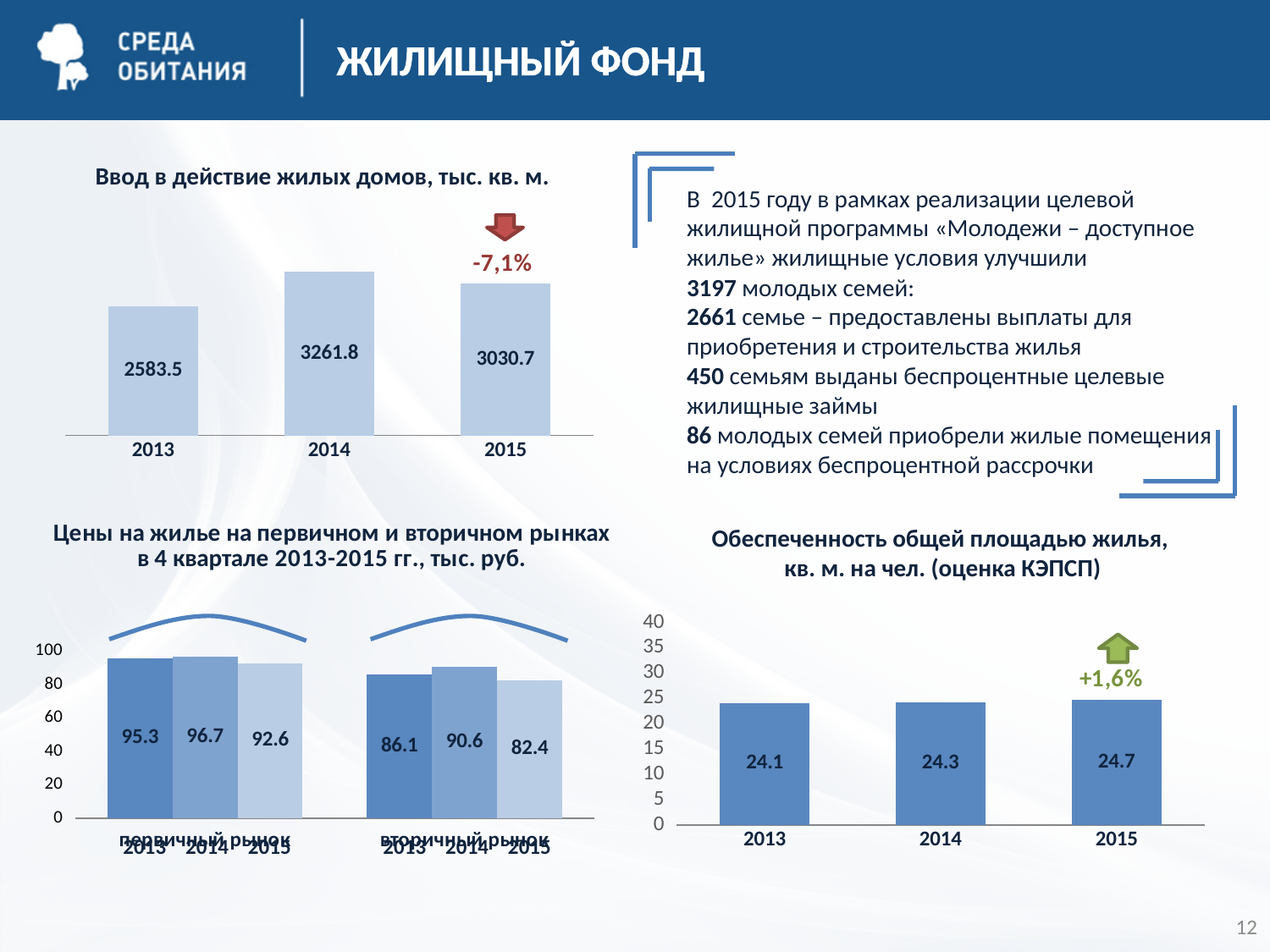
In the chart 'Цены на жилье на первичном и вторичном рынках', what is the difference between the 2014 and 2015 values on the вторичный рынок? 8.2 In the chart 'Обеспеченность общей площадью жилья, кв. м. на чел.', do the values rise or fall from 2013 to 2015? rise In the chart 'Цены на жилье на первичном и вторичном рынках', what is the value for 2014 on the первичный рынок? 96.7 In the chart 'Цены на жилье на первичном и вторичном рынках', what is the value for 2015 on the вторичный рынок? 82.4 In the chart 'Цены на жилье на первичном и вторичном рынках', which is larger: the 2013 value for первичный рынок or the 2013 value for вторичный рынок? первичный рынок In the chart 'Ввод в действие жилых домов, тыс. кв. м.', what percentage change is annotated above the 2015 bar? -7,1% What kind of chart is 'Обеспеченность общей площадью жилья, кв. м. на чел.'? bar chart In the chart 'Обеспеченность общей площадью жилья, кв. м. на чел.', what is the value for 2015? 24.7 In the chart 'Ввод в действие жилых домов, тыс. кв. м.', what is the value for 2014? 3261.8 In the chart 'Ввод в действие жилых домов, тыс. кв. м.', what is the difference between the 2014 and 2015 values? 231.1 In the chart 'Обеспеченность общей площадью жилья, кв. м. на чел.', is the value for 2013 greater or less than 25? less In the chart 'Ввод в действие жилых домов, тыс. кв. м.', which year has the lowest value? 2013